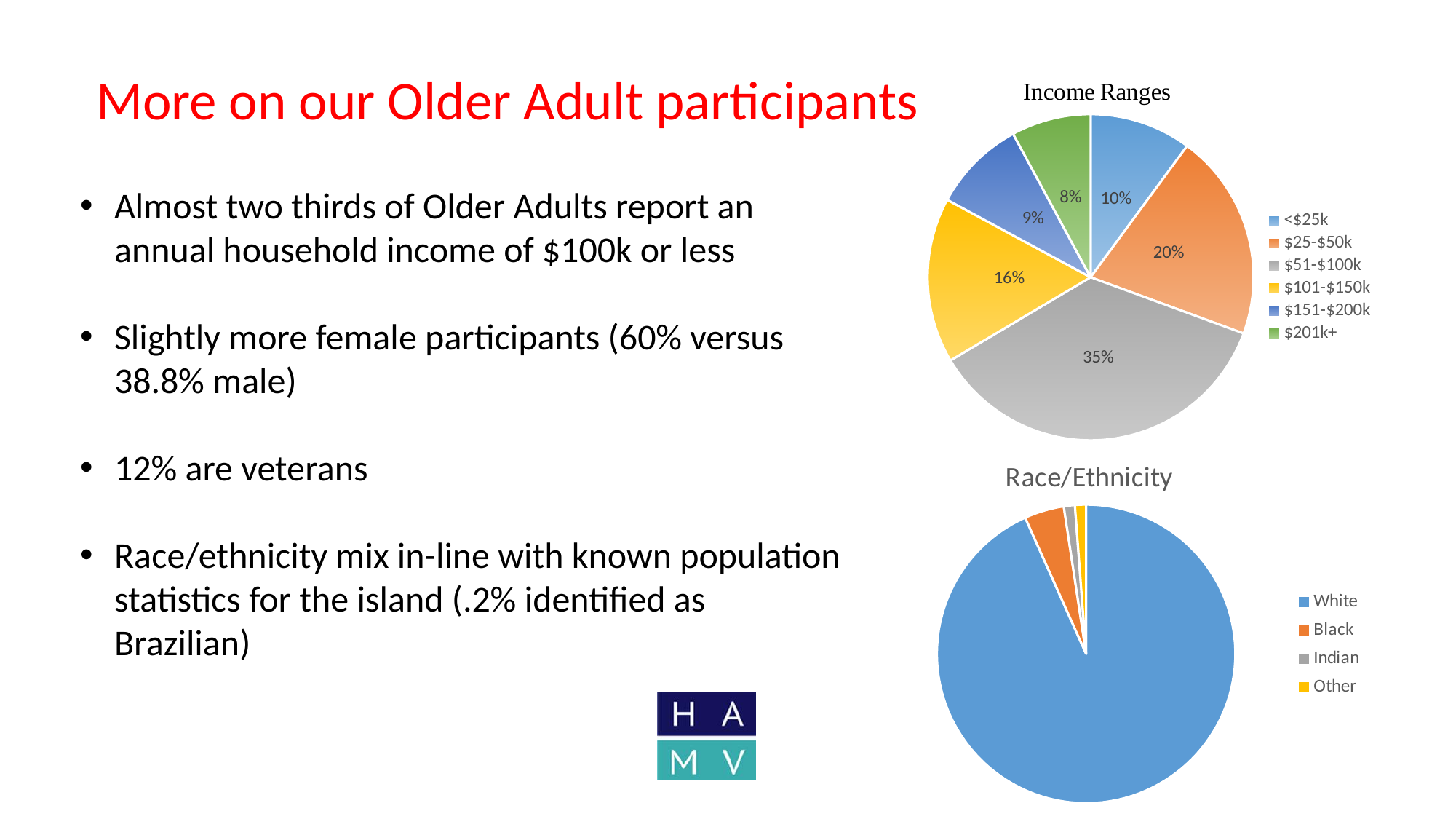
How many categories does the legend of the Race/Ethnicity chart list? 4 What type of chart is the Race/Ethnicity chart? Pie chart How many income ranges are shown in the Income Ranges chart? 6 In the Income Ranges chart, which slice is larger: <$25k or $151-$200k? <$25k In the Income Ranges chart, which income range has the smallest share? $201k+ In the Income Ranges chart, which income range has the largest share? $51-$100k In the Race/Ethnicity chart, which category has the largest slice? White In the Income Ranges chart, what percentage is shown for the $201k+ range? 8% In the Income Ranges chart, what is the difference in percentage points between the $51-$100k and $101-$150k slices? 19 In the Income Ranges chart, what percentage is shown for the $25-$50k range? 20% In the Race/Ethnicity chart, what colour represents the Black category? Orange In the Income Ranges chart, what share of participants report an income of $51-$100k? 35%